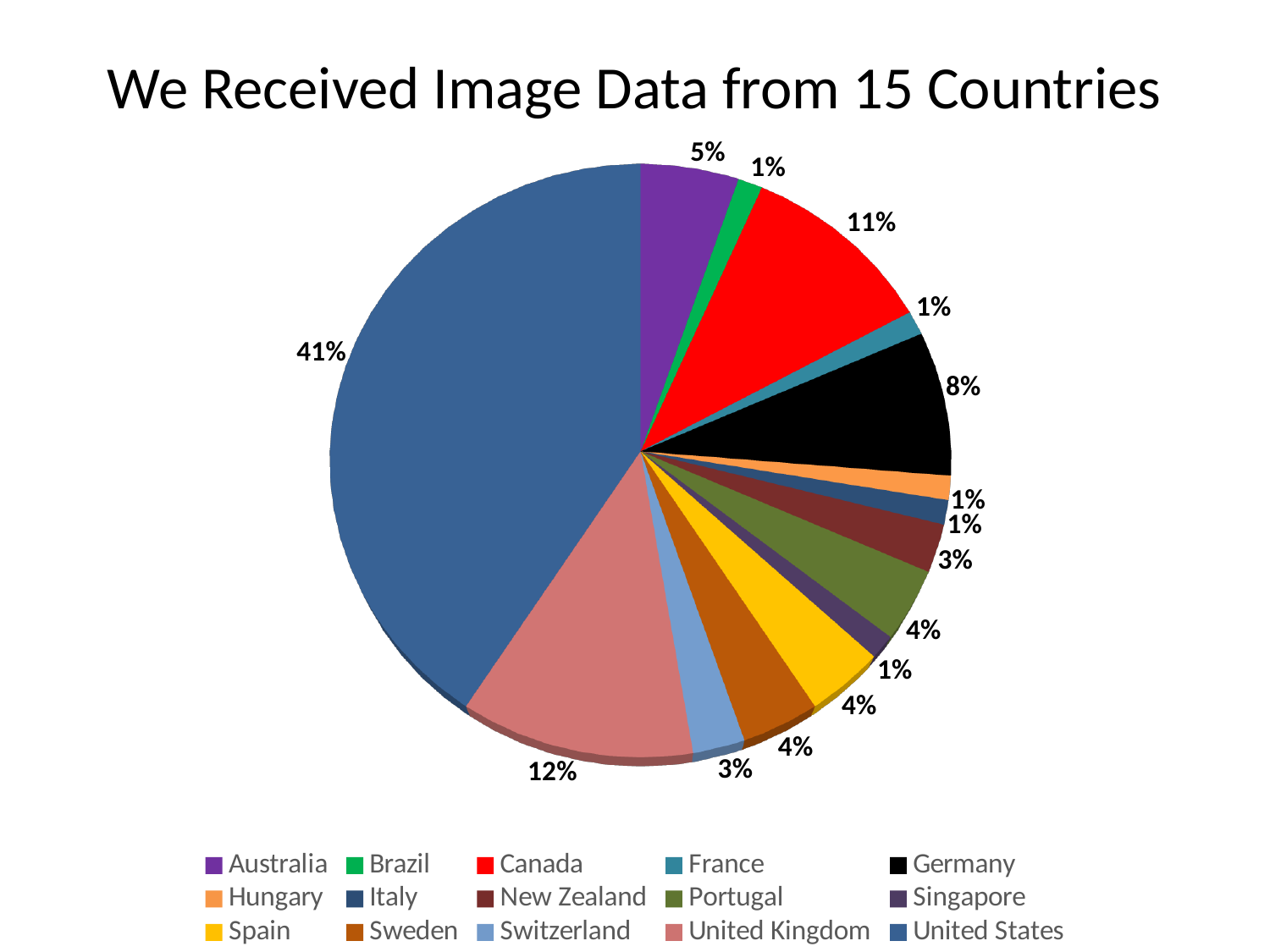
What is the difference in percentage points between the United States slice and the United Kingdom slice? 29 What percentage is shown for Canada? 11% What percentage is shown for the United Kingdom? 12% What type of chart is shown on the slide? Pie chart How many countries are listed in the legend? 15 Which is larger, the slice for Canada or the slice for the United Kingdom? United Kingdom What share of the pie does the United States slice represent? 41% Which country is represented by the black slice? Germany What percentage is shown for Germany? 8% Which country has the largest slice of the pie? United States What is the title of the slide? We Received Image Data from 15 Countries What percentage is shown for Australia? 5%